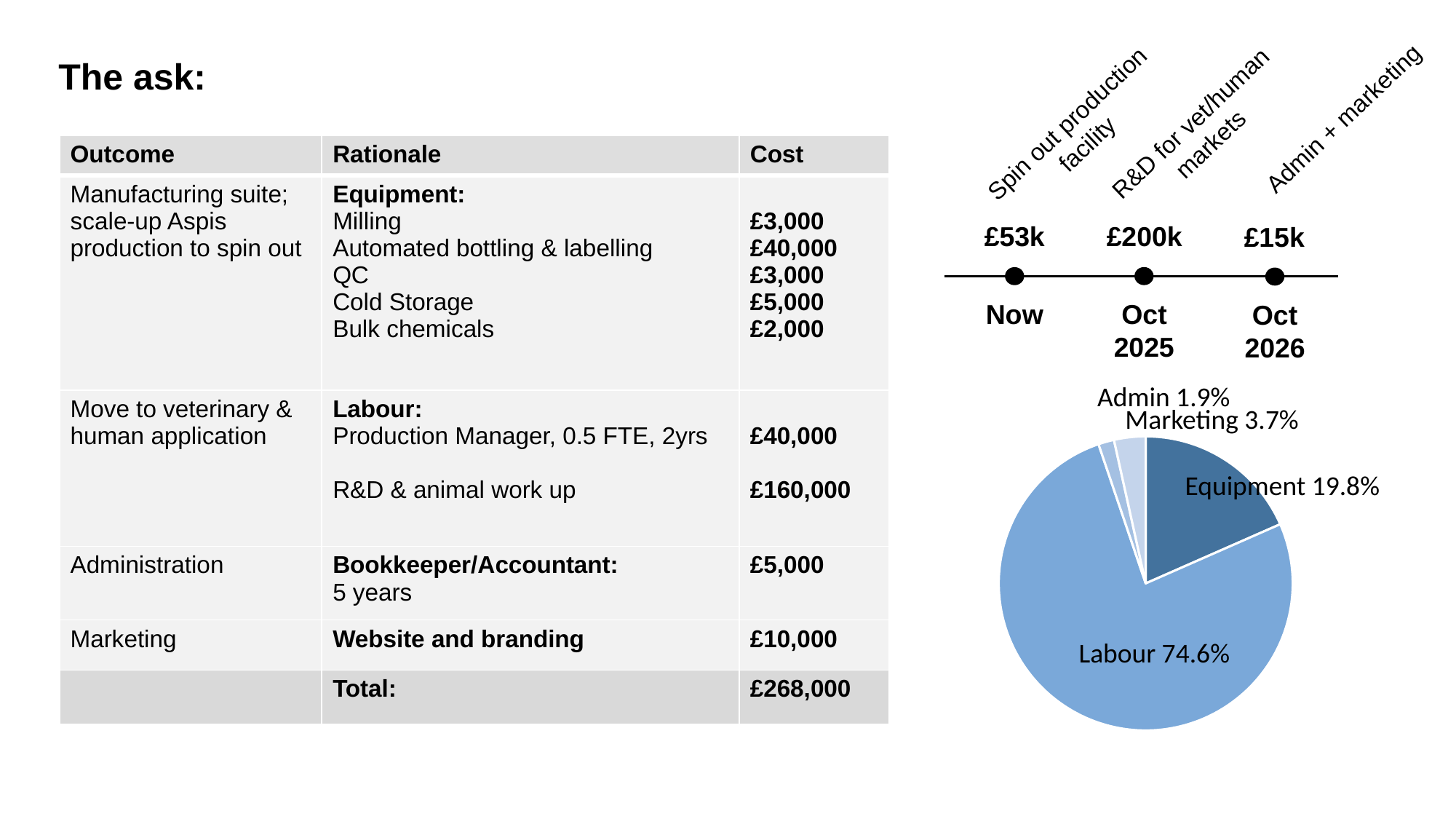
What type of chart is shown on the slide? pie chart In the pie chart, which is larger, Equipment or Marketing? Equipment What is the difference in percentage points between the Marketing and Admin slices of the pie chart? 1.8 What share of the pie chart is Labour? 74.6% What share of the pie chart is Equipment? 19.8% Which slice of the pie chart is the smallest? Admin Which slice of the pie chart is the largest? Labour What is the difference in percentage points between the Labour and Equipment slices of the pie chart? 54.8 Which slice of the pie chart is shown in the darkest blue? Equipment What share of the pie chart is Admin? 1.9% How many slices does the pie chart have? 4 What share of the pie chart is Marketing? 3.7%